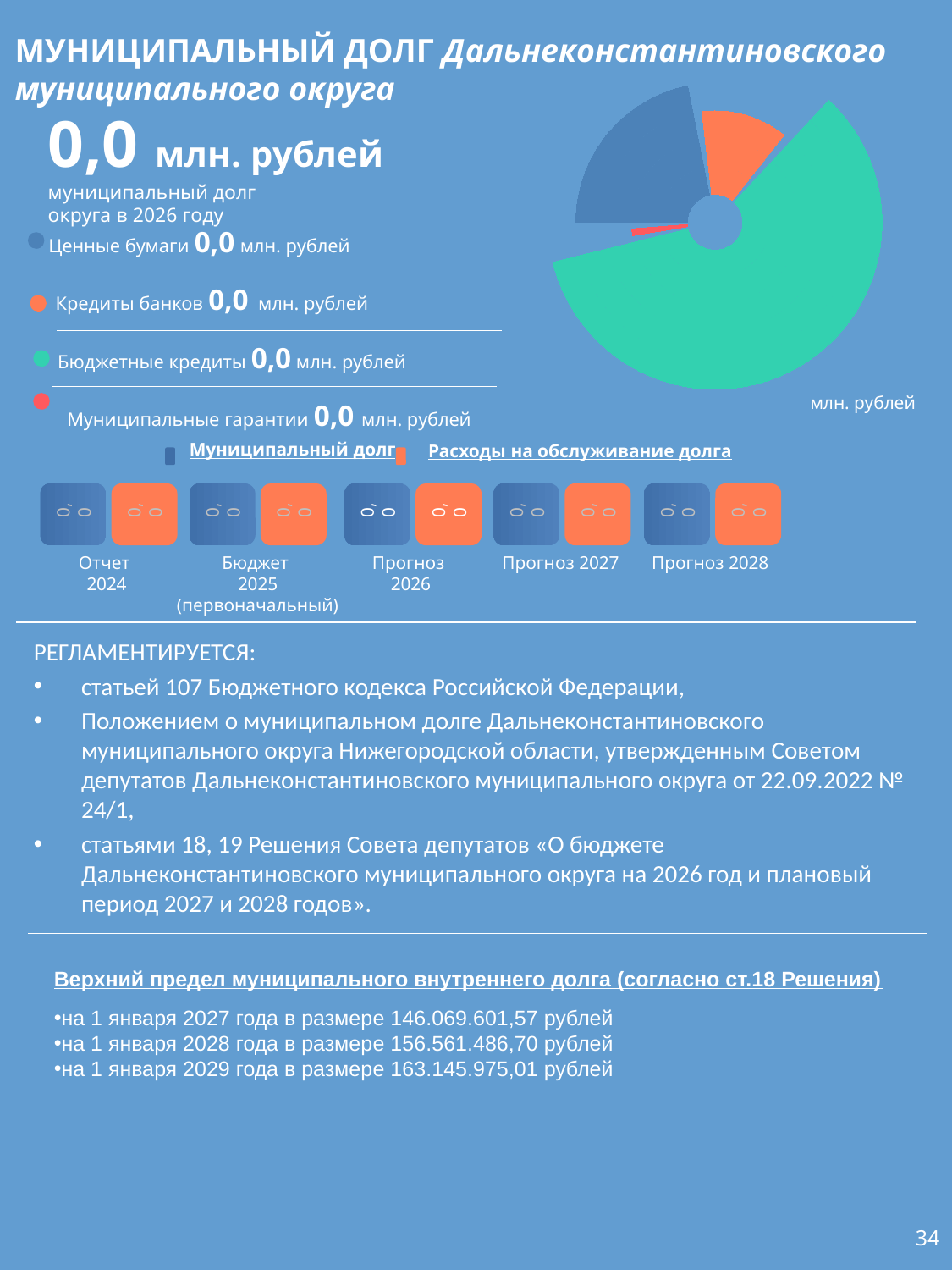
According to the pie chart legend on the left, what is the value for Кредиты банков? 0,0 млн. рублей In the pie chart in the top right, how many slices are there? 4 According to the pie chart legend on the left, what is the value for Муниципальные гарантии? 0,0 млн. рублей What is the municipal debt of the district in 2026 as stated above the pie chart legend? 0,0 млн. рублей According to the pie chart legend on the left, what is the value for Бюджетные кредиты? 0,0 млн. рублей According to the pie chart legend on the left, what is the value for Ценные бумаги? 0,0 млн. рублей What kind of chart is shown in the top right of the slide? doughnut chart